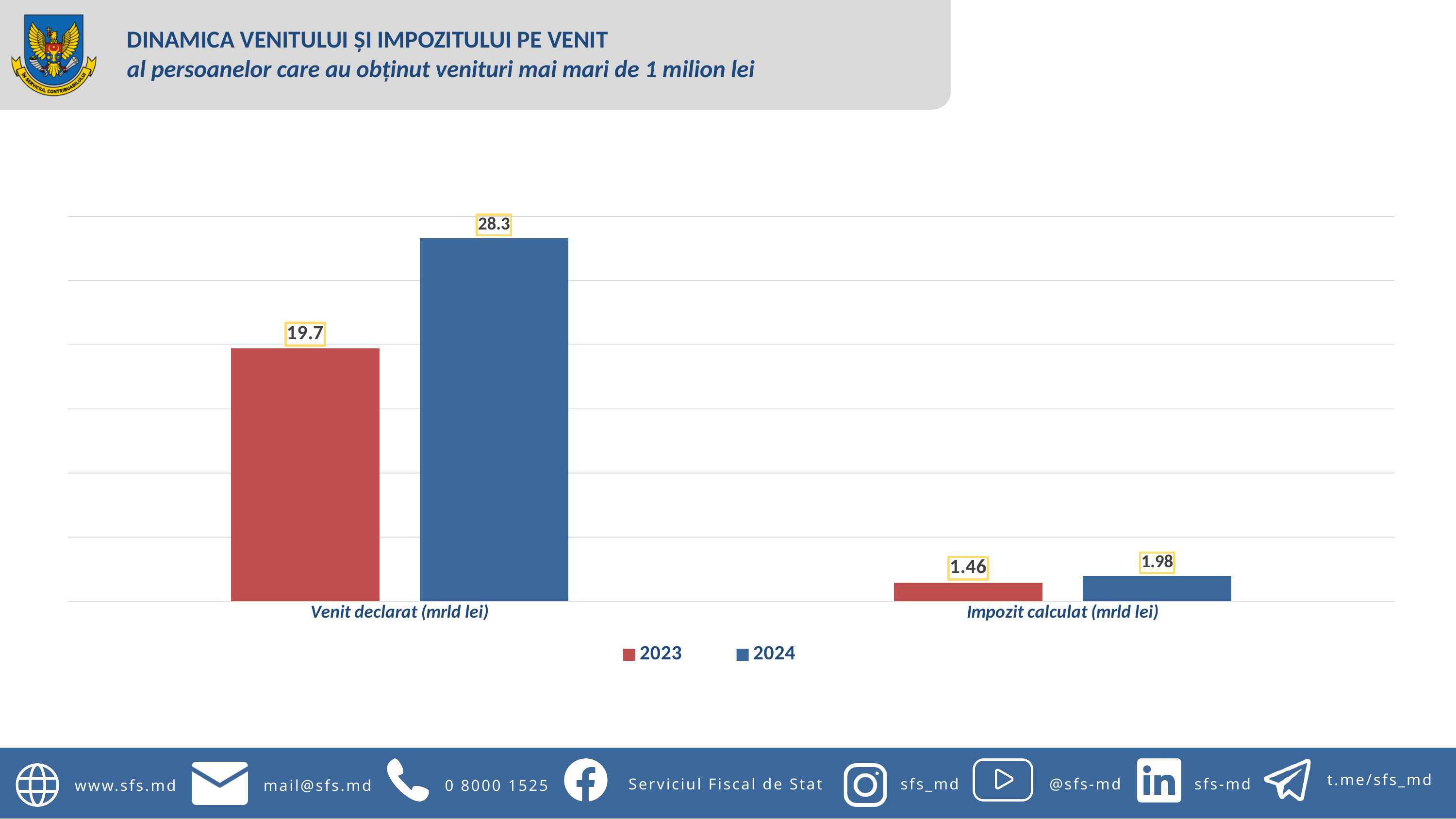
What is the difference between the 2024 and 2023 values for Impozit calculat (mrld lei)? 0.52 What is the value for 2023 in the Venit declarat (mrld lei) category? 19.7 Which bar has the lowest value on the chart? 2023, Impozit calculat (mrld lei) Which bar has the highest value on the chart? 2024, Venit declarat (mrld lei) What is the difference between the 2024 and 2023 values for Venit declarat (mrld lei)? 8.6 What is the value for 2024 in the Venit declarat (mrld lei) category? 28.3 What is the value for 2023 in the Impozit calculat (mrld lei) category? 1.46 What is the value for 2024 in the Impozit calculat (mrld lei) category? 1.98 How many series does the legend list? 2 How many categories are shown on the x axis? 2 What kind of chart is shown on the slide? Bar chart Which is larger for Impozit calculat (mrld lei): the 2023 value or the 2024 value? 2024